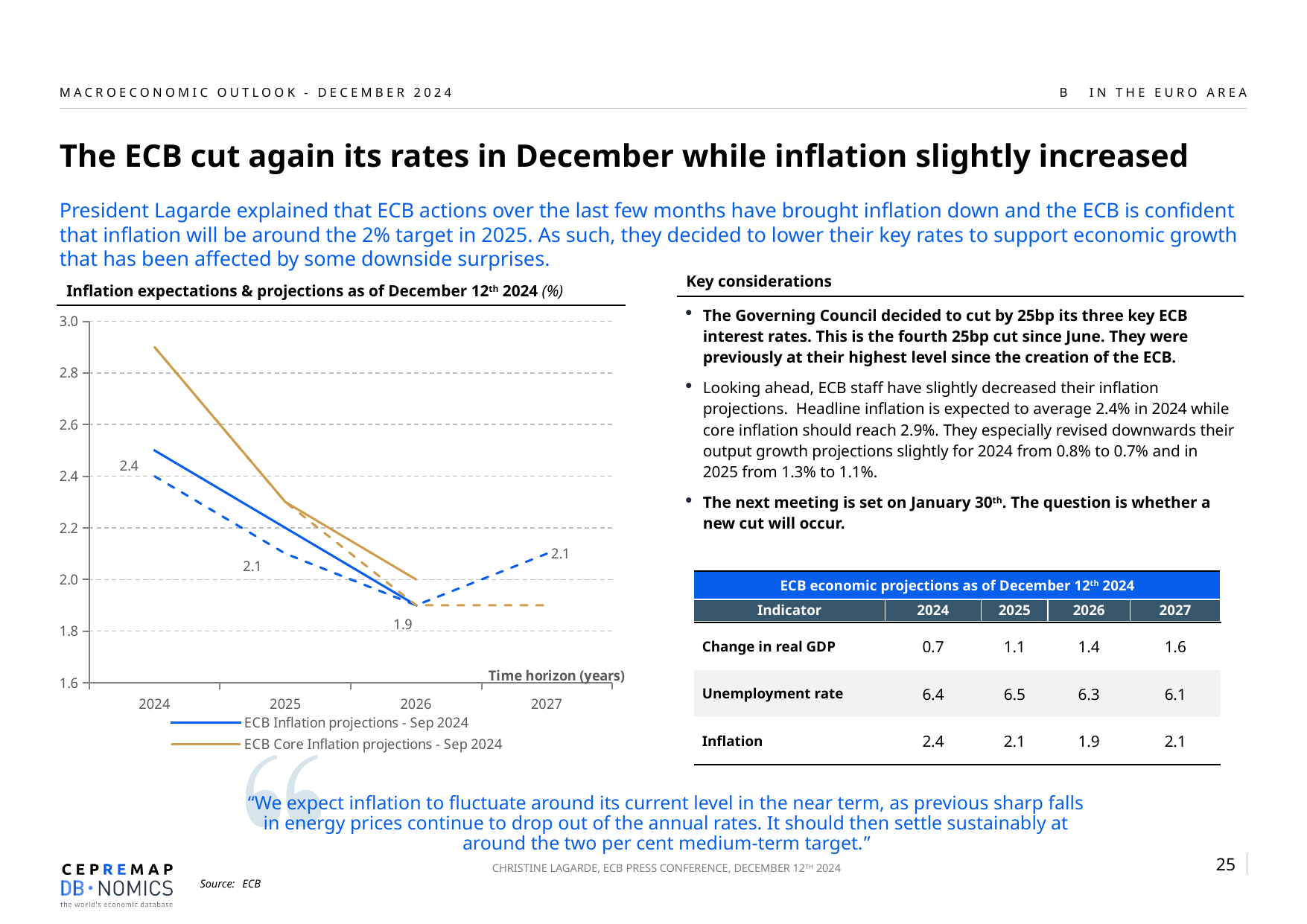
Does the ECB Inflation projections - Sep 2024 line rise or fall from 2024 to 2026? fall In which year does the dashed blue line reach its lowest labelled value? 2026 Is the value of the ECB Inflation projections - Sep 2024 line in 2024 greater or less than 2.4? greater What is the title of the chart's x axis? Time horizon (years) What value is labelled on the dashed blue line for 2024? 2.4 How many years are shown on the x axis of the chart? 4 What value is labelled on the dashed blue line for 2027? 2.1 Is the value of the ECB Core Inflation projections - Sep 2024 line in 2024 greater or less than 2.8? greater What kind of chart is shown on the slide? line chart What is the difference between the labelled values on the dashed blue line for 2024 and 2026? 0.5 What value is labelled on the dashed blue line for 2026? 1.9 How many series does the chart's legend list? 2